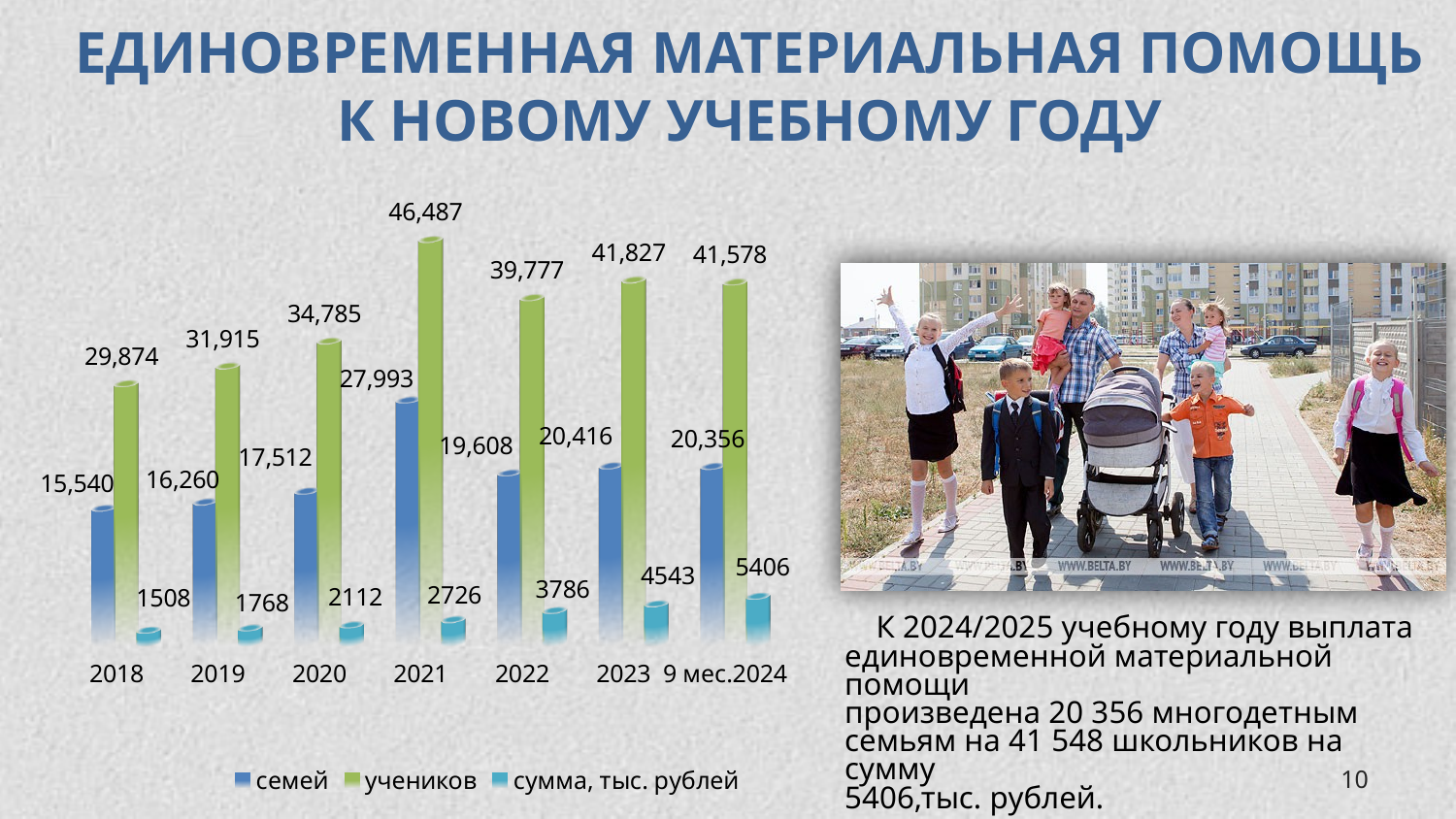
Which year has the highest value for семей? 2021 What is the value for учеников in 2021? 46,487 What is the difference between the учеников values for 2021 and 2020? 11,702 How many series does the legend list? 3 Which is larger: the семей value for 2023 or for 9 мес.2024? 2023 Which colour represents the учеников series in the chart? green What kind of chart is shown on the slide? bar chart What is the value for сумма, тыс. рублей in 9 мес.2024? 5406 Which category has the lowest value for сумма, тыс. рублей? 2018 Does the сумма, тыс. рублей series rise or fall from 2018 to 9 мес.2024? rise How many categories are shown on the x axis? 7 What is the value for семей in 2018? 15,540